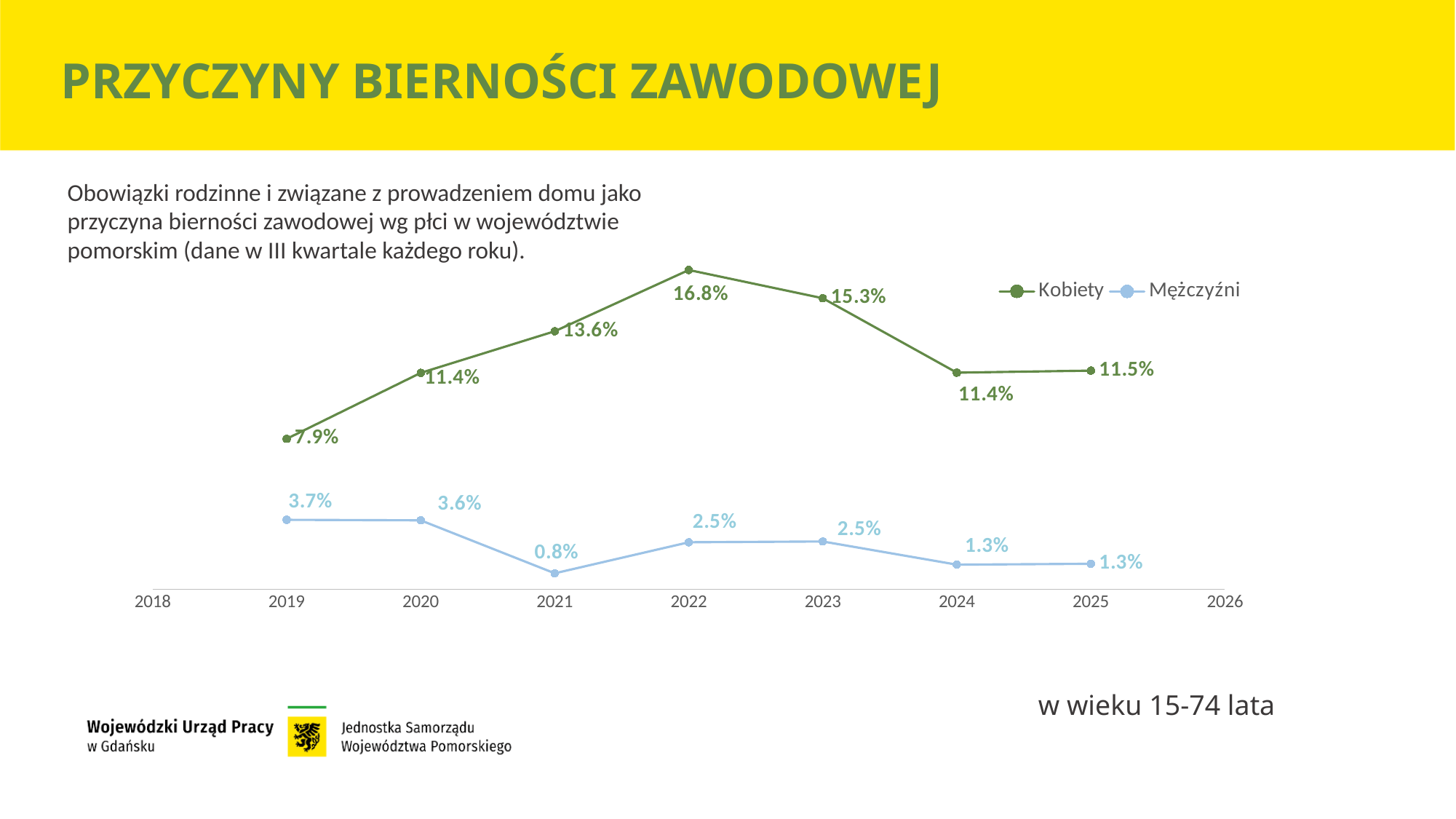
Does the Kobiety series rise or fall from 2022 to 2024? fall What is the value for Kobiety in 2019? 7.9% How many years are plotted for each series? 7 What is the value for Kobiety in 2022? 16.8% What is the value for Mężczyźni in 2021? 0.8% In which year is the value for Kobiety highest? 2022 In which year is the value for Mężczyźni lowest? 2021 What is the difference between the Kobiety and Mężczyźni values in 2023? 12.8% Which is larger: the Kobiety value in 2020 or the Kobiety value in 2021? 2021 What type of chart is shown on the slide? line chart What are the two legend entries of the chart? Kobiety and Mężczyźni How many series does the legend list? 2